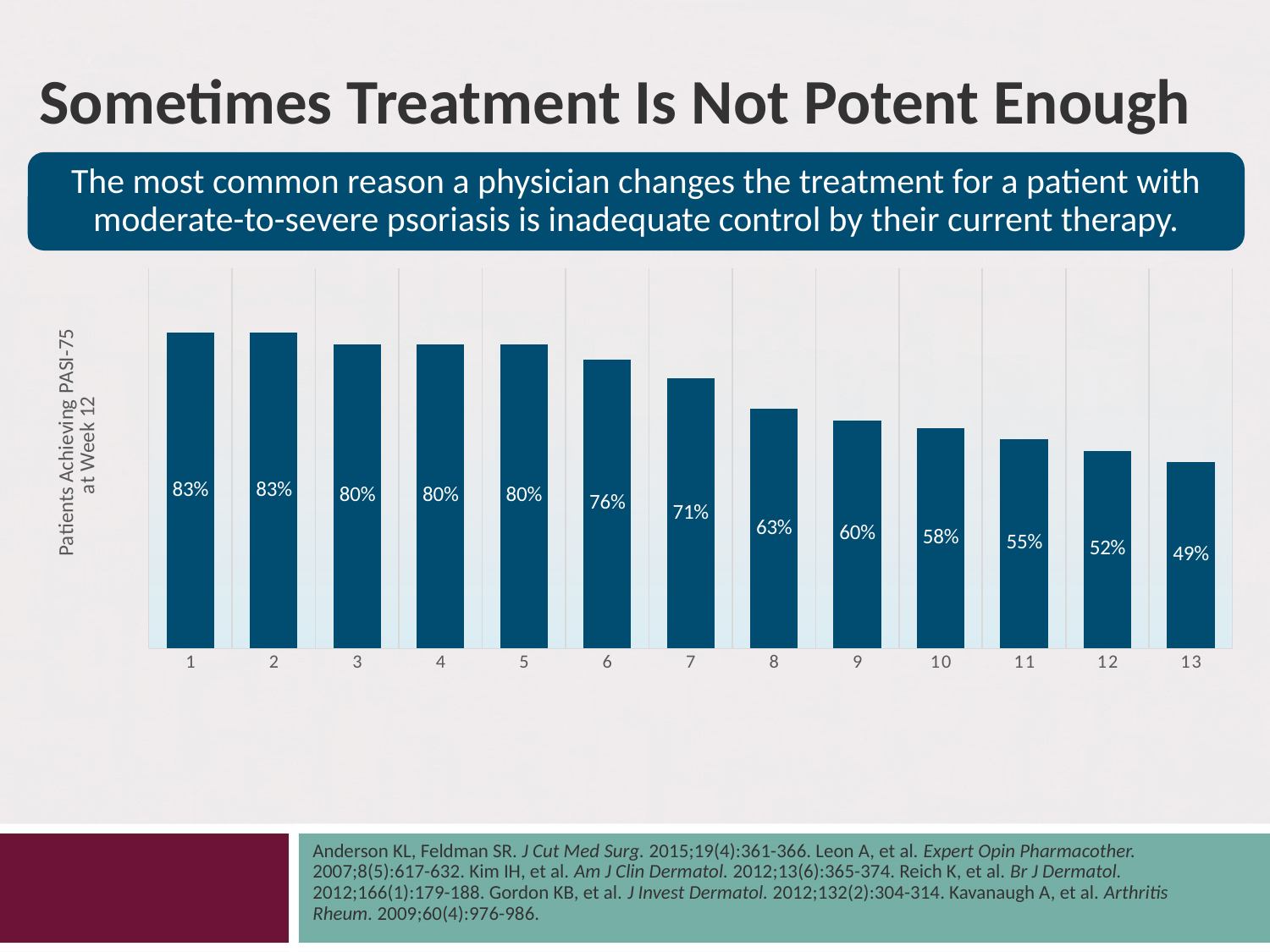
Which is larger, the value for category 9 or the value for category 11? category 9 What kind of chart is shown on the slide? bar chart How many categories have a value of 80%? 3 What is the value for category 6? 76% What is the y-axis label of the chart? Patients Achieving PASI-75 at Week 12 How many categories are shown on the x axis? 13 What is the difference between the values for category 7 and category 8? 8% Which category has the lowest value? 13 What is the value for category 10? 58% Do the values rise or fall from category 1 to category 13? fall What is the difference between the values for category 1 and category 13? 34% What is the value for category 13? 49%